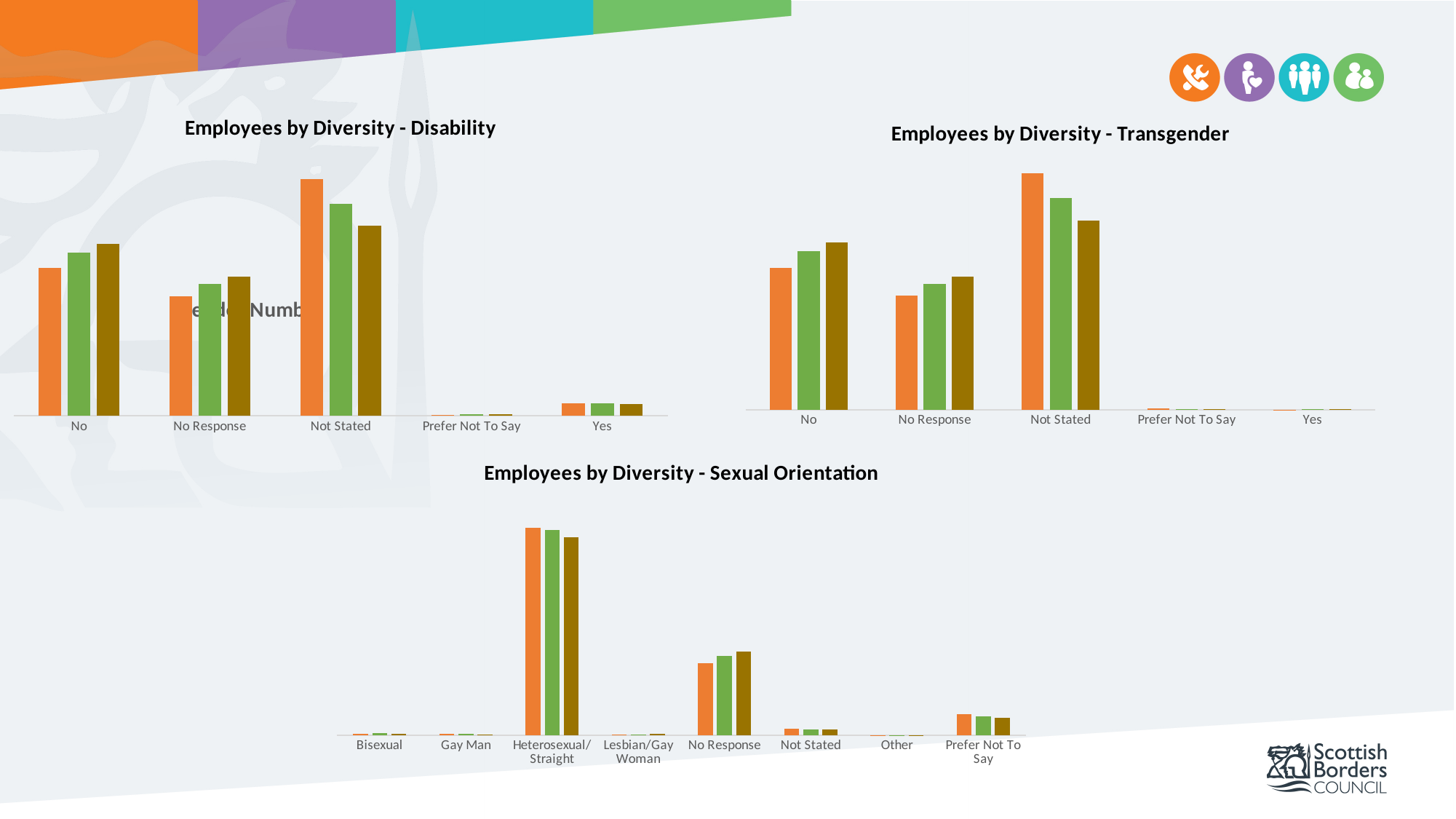
In the 'Employees by Diversity - Transgender' chart, which category has the highest bars? Not Stated In the 'Employees by Diversity - Sexual Orientation' chart, which category has higher bars, 'No Response' or 'Prefer Not To Say'? No Response In the 'Employees by Diversity - Sexual Orientation' chart, which category has the highest bars? Heterosexual/Straight In the 'Employees by Diversity - Disability' chart, which category has higher bars, 'No' or 'No Response'? No In the 'Employees by Diversity - Transgender' chart, which category has higher bars, 'No' or 'No Response'? No What is the title of the chart at the bottom of the slide? Employees by Diversity - Sexual Orientation What kind of chart is 'Employees by Diversity - Disability'? bar chart In the 'Employees by Diversity - Sexual Orientation' chart, how many categories are shown on the x axis? 8 In the 'Employees by Diversity - Disability' chart, which category has the lowest bars? Prefer Not To Say In the 'Employees by Diversity - Transgender' chart, how many categories are shown on the x axis? 5 In the 'Employees by Diversity - Disability' chart, which category has the highest bars? Not Stated In the 'Employees by Diversity - Disability' chart, how many categories are shown on the x axis? 5